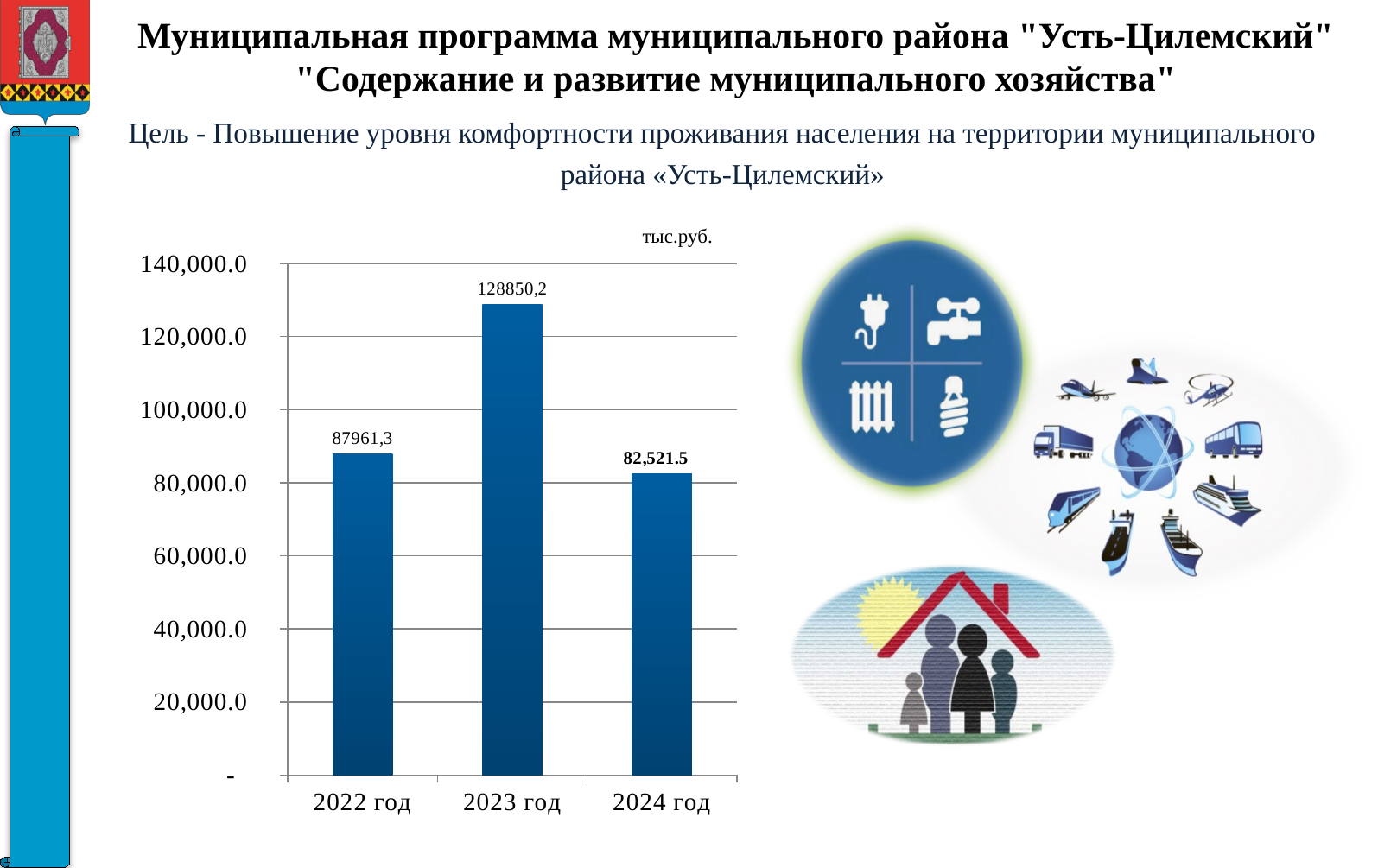
Which year has the lowest value? 2024 год Do the values rise or fall from 2023 год to 2024 год? fall What unit is indicated above the chart? тыс.руб. What is the value shown for 2024 год? 82,521.5 Is the value for 2022 год greater or less than 100,000.0? less What is the value shown for 2022 год? 87961,3 What is the value shown for 2023 год? 128850,2 How many years are shown on the x axis? 3 What kind of chart is shown on the slide? bar chart Which year has the highest value? 2023 год Which is larger, the value for 2022 год or the value for 2024 год? 2022 год Is the value for 2023 год greater or less than 120,000.0? greater